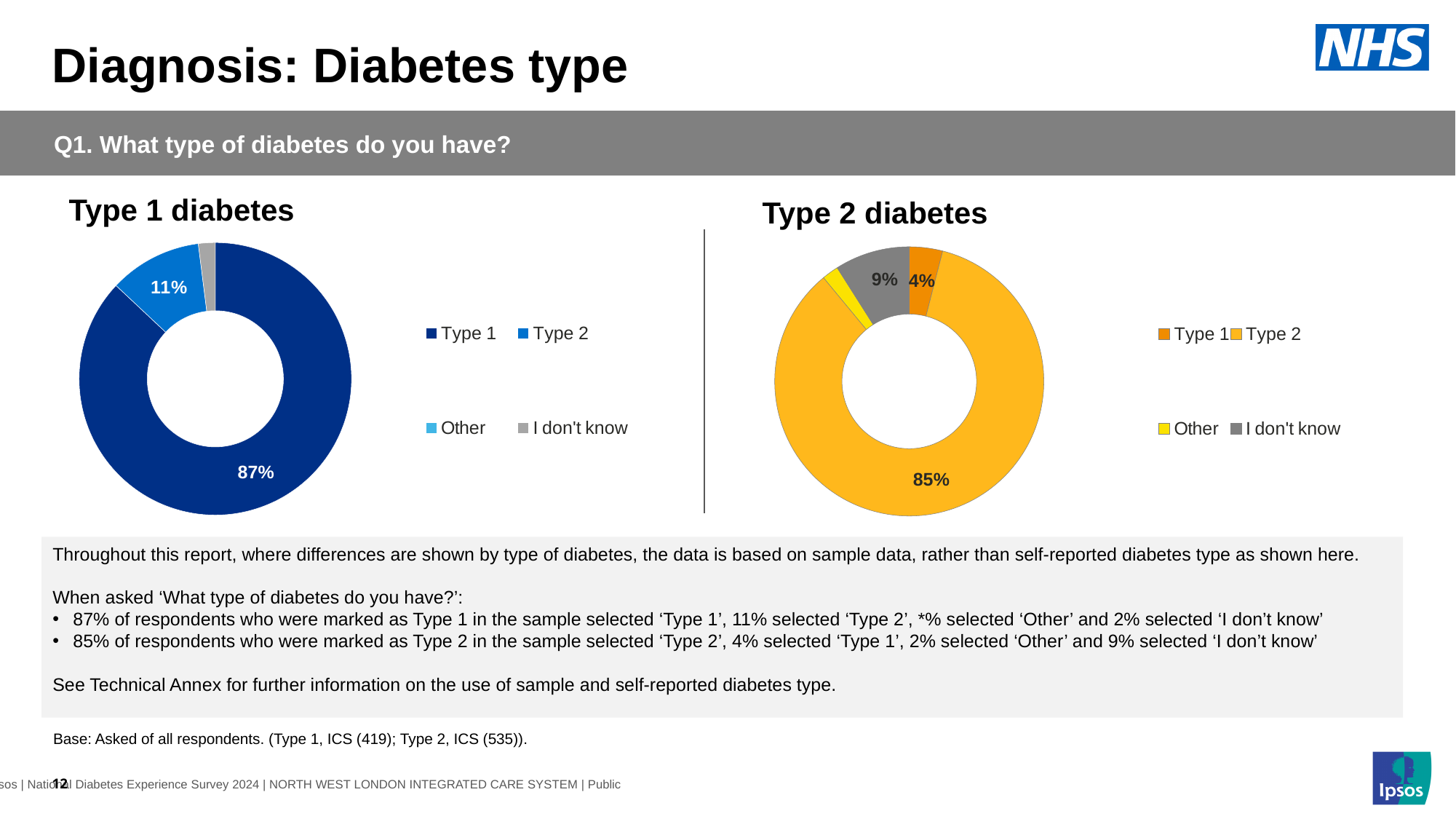
In the Type 2 diabetes chart, what is the difference between the 'I don't know' and 'Type 1' shares? 5 percentage points In the Type 2 diabetes chart, what percentage of respondents selected 'Type 1'? 4% In the Type 1 diabetes chart, what is the difference between the 'Type 1' and 'Type 2' shares? 76 percentage points How many categories does the legend of the Type 1 diabetes chart list? 4 In the Type 2 diabetes chart, what percentage of respondents selected 'I don't know'? 9% In the Type 2 diabetes chart, which is larger: the 'I don't know' share or the 'Type 1' share? I don't know In the Type 2 diabetes chart, which category has the largest share? Type 2 In the Type 1 diabetes chart, what percentage of respondents selected 'Type 1'? 87% In the Type 1 diabetes chart, what percentage of respondents selected 'Type 2'? 11% In the Type 2 diabetes chart, what percentage of respondents selected 'Type 2'? 85% In the Type 1 diabetes chart, which category has the largest share? Type 1 What kind of chart is used on this slide? Donut (pie) chart